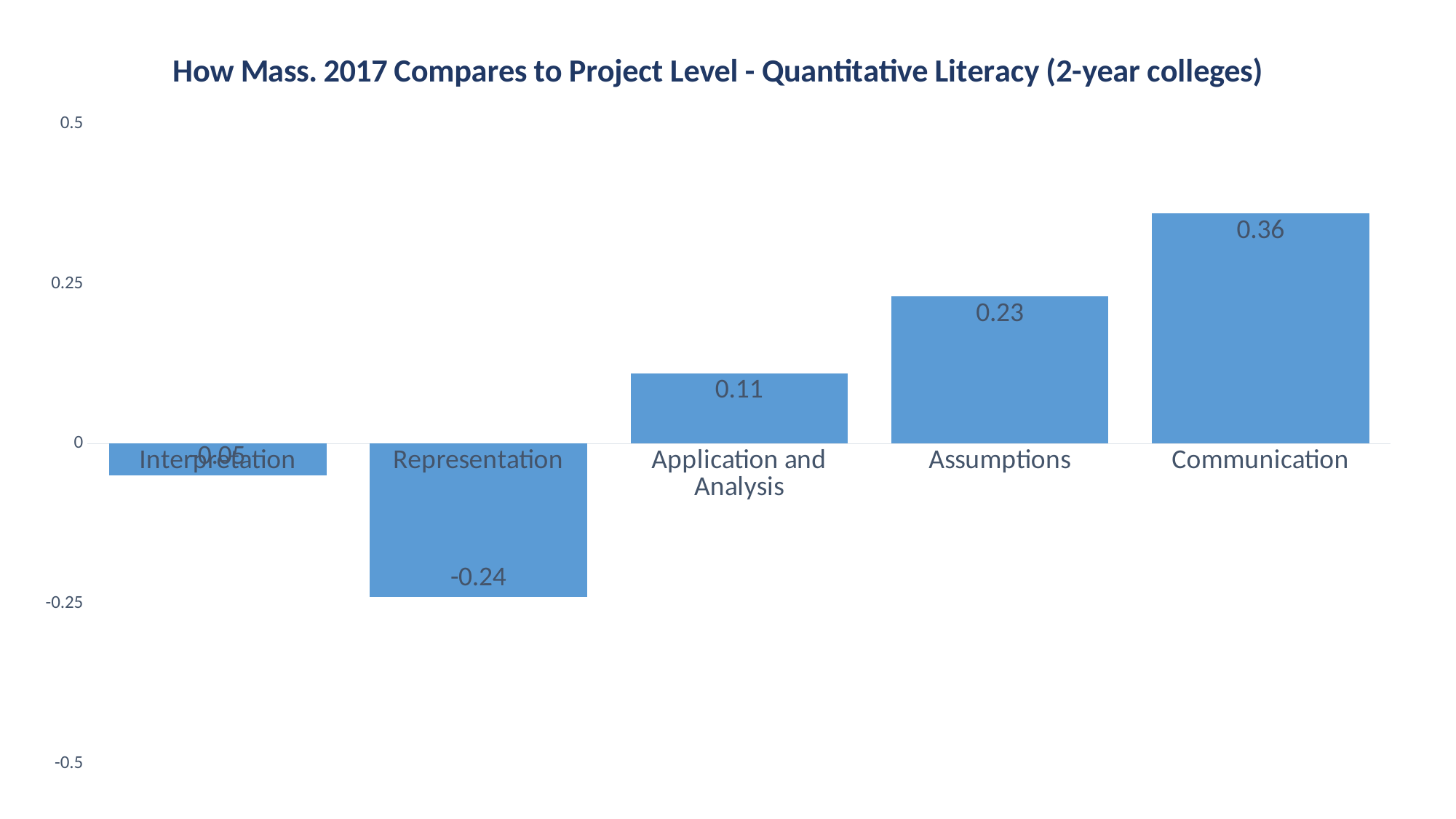
What is the value for Assumptions? 0.23 Which is larger, the value for Assumptions or the value for Application and Analysis? Assumptions What kind of chart is shown on the slide? bar chart What is the value for Communication? 0.36 Which category has the highest value? Communication What is the difference between the values for Assumptions and Application and Analysis? 0.12 What is the value for Representation? -0.24 How many categories are shown in the chart? 5 Is the value for Interpretation greater or less than 0? less What is the difference between the values for Communication and Assumptions? 0.13 What is the value for Application and Analysis? 0.11 Which category has the lowest value? Representation